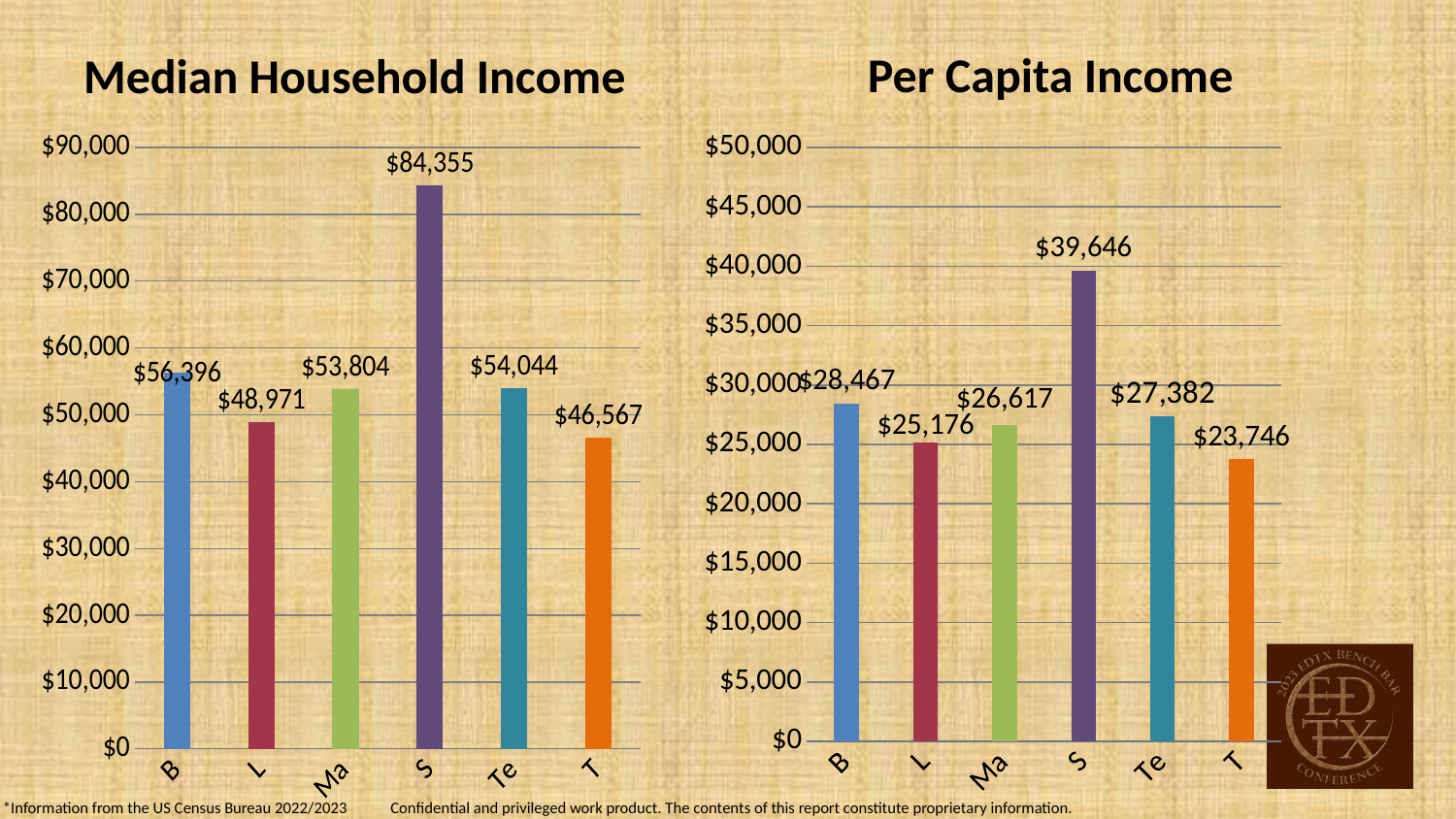
In the Median Household Income chart, what is the difference between the values for S and B? $27,959 In the Median Household Income chart, which category has the highest value? S What kind of chart is the Per Capita Income chart? bar chart How many categories are shown in the Median Household Income chart? 6 In the Per Capita Income chart, what is the value for Ma? $26,617 In the Per Capita Income chart, which is larger, the value for B or the value for Te? B In the Median Household Income chart, what is the value for S? $84,355 In the Per Capita Income chart, what is the value for T? $23,746 In the Per Capita Income chart, what is the difference between the values for S and L? $14,470 What is the title of the chart on the left side of the slide? Median Household Income In the Per Capita Income chart, which category has the lowest value? T In the Median Household Income chart, is the value for L greater or less than $50,000? less